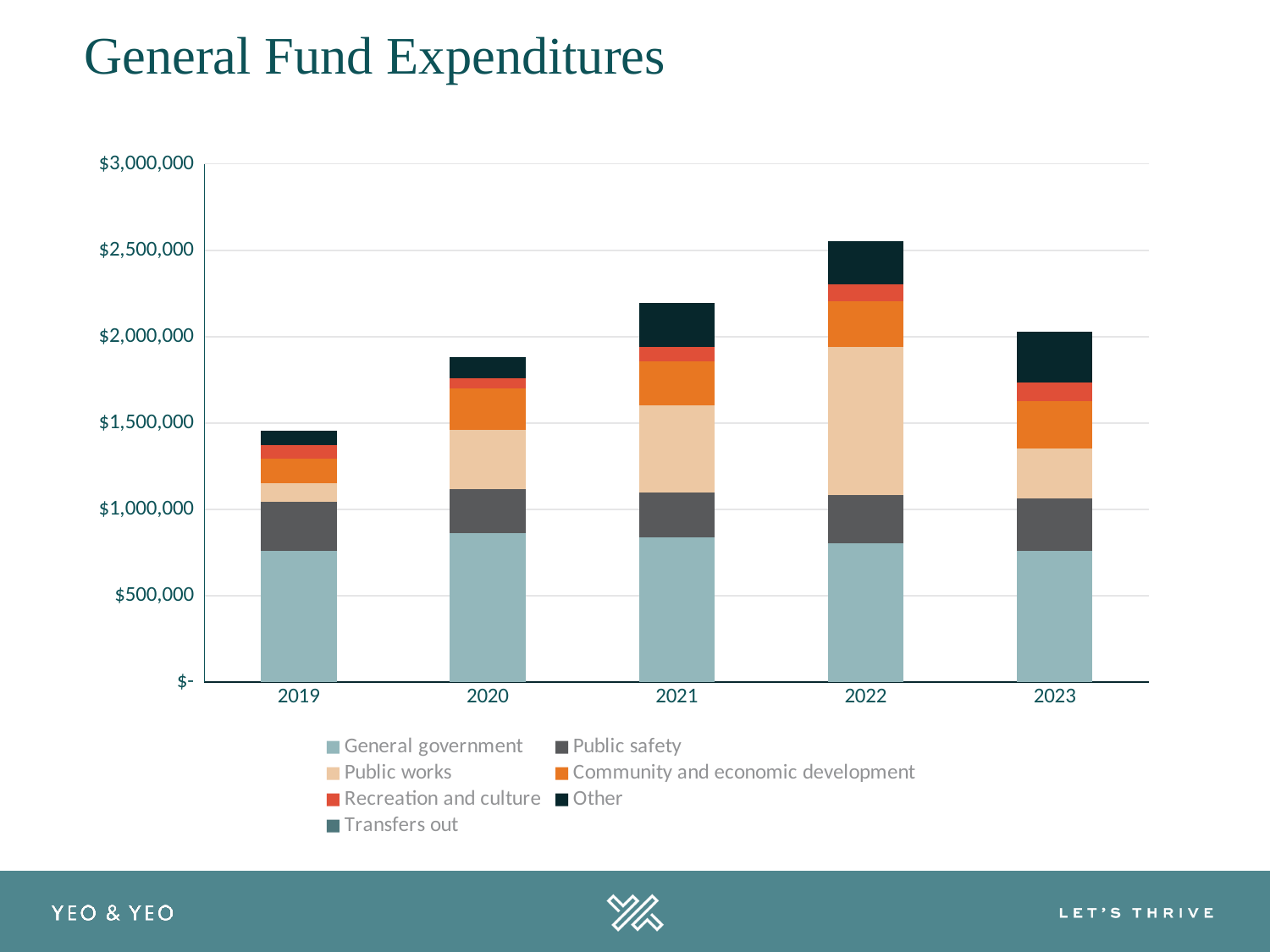
How many series does the legend list? 7 How many years are shown on the x axis of the chart? 5 Which series forms the bottom segment of each stacked bar? General government Which year has the larger total expenditure, 2020 or 2021? 2021 Do total expenditures rise or fall from 2019 to 2022? rise What is the title of the chart? General Fund Expenditures Is the total expenditure for 2019 greater or less than $1,500,000? less Which year has the lowest total general fund expenditures? 2019 What kind of chart is shown on the slide? Stacked bar chart Is the total expenditure for 2022 greater or less than $2,500,000? greater Is the total expenditure for 2020 greater or less than $2,000,000? less Which year has the highest total general fund expenditures? 2022